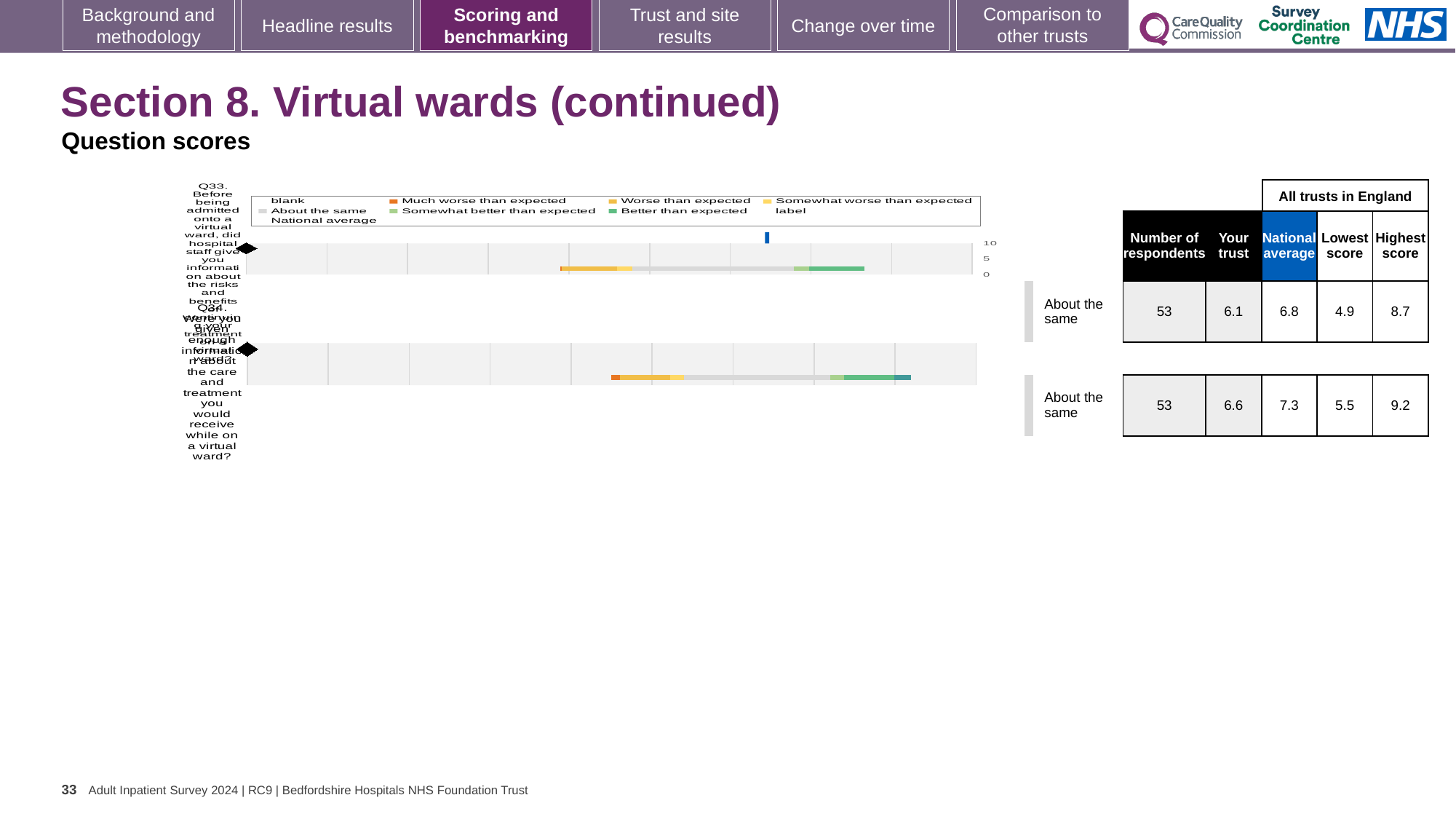
Which question has the higher 'Your trust' score, Q33 or Q34? Q34 What benchmark category is shown for Q34? About the same In the table next to the chart, what is the highest score for Q34? 9.2 What is the difference between the national average and the 'Your trust' score for Q33? 0.7 How many questions (bars) are plotted in the chart? 2 In the table next to the chart, what is the lowest score for Q33? 4.9 Which colour in the legend represents 'Better than expected'? Green In the table next to the chart, what is the 'Your trust' score for Q33? 6.1 What kind of chart is shown on the slide? Bar chart Which colour in the legend represents 'Much worse than expected'? Orange In the table next to the chart, what is the national average for Q34? 7.3 How many respondents are listed for Q33? 53